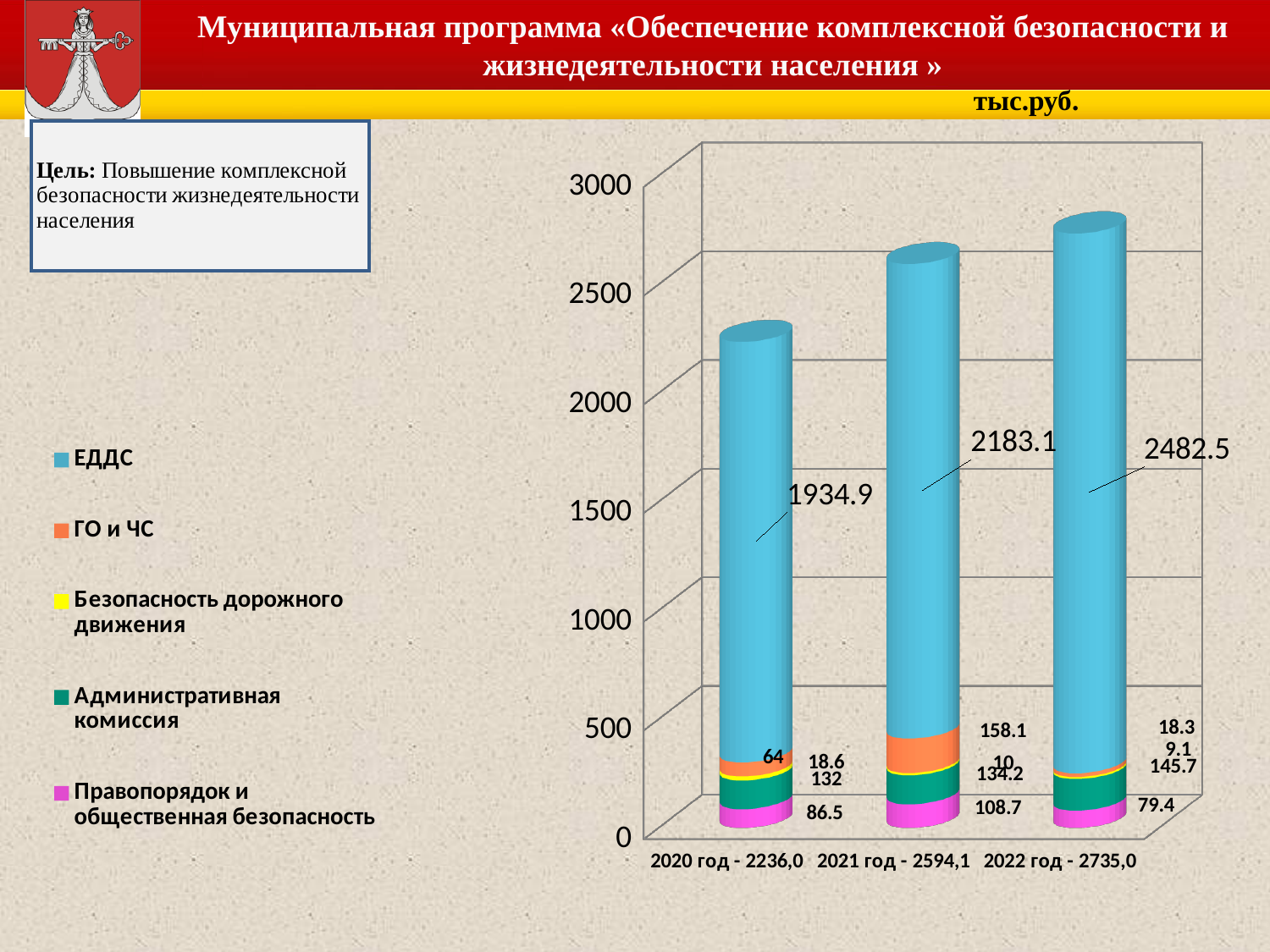
In which year is the ЕДДС value highest? 2022 год What is the value of ЕДДС for 2020 год? 1934.9 How many years (categories) are shown on the x axis? 3 Which is larger: Правопорядок и общественная безопасность in 2021 год or in 2020 год? 2021 год What is the difference between the ЕДДС values for 2022 год and 2021 год? 299.4 What is the total of the stacked bar for 2021 год? 2594,1 What is the value of Правопорядок и общественная безопасность for 2022 год? 79.4 In which year is the ГО и ЧС value lowest? 2022 год What is the value of ГО и ЧС for 2021 год? 158.1 How many series does the legend list? 5 What kind of chart is shown on the slide? Stacked bar chart What is the value of Административная комиссия for 2021 год? 134.2